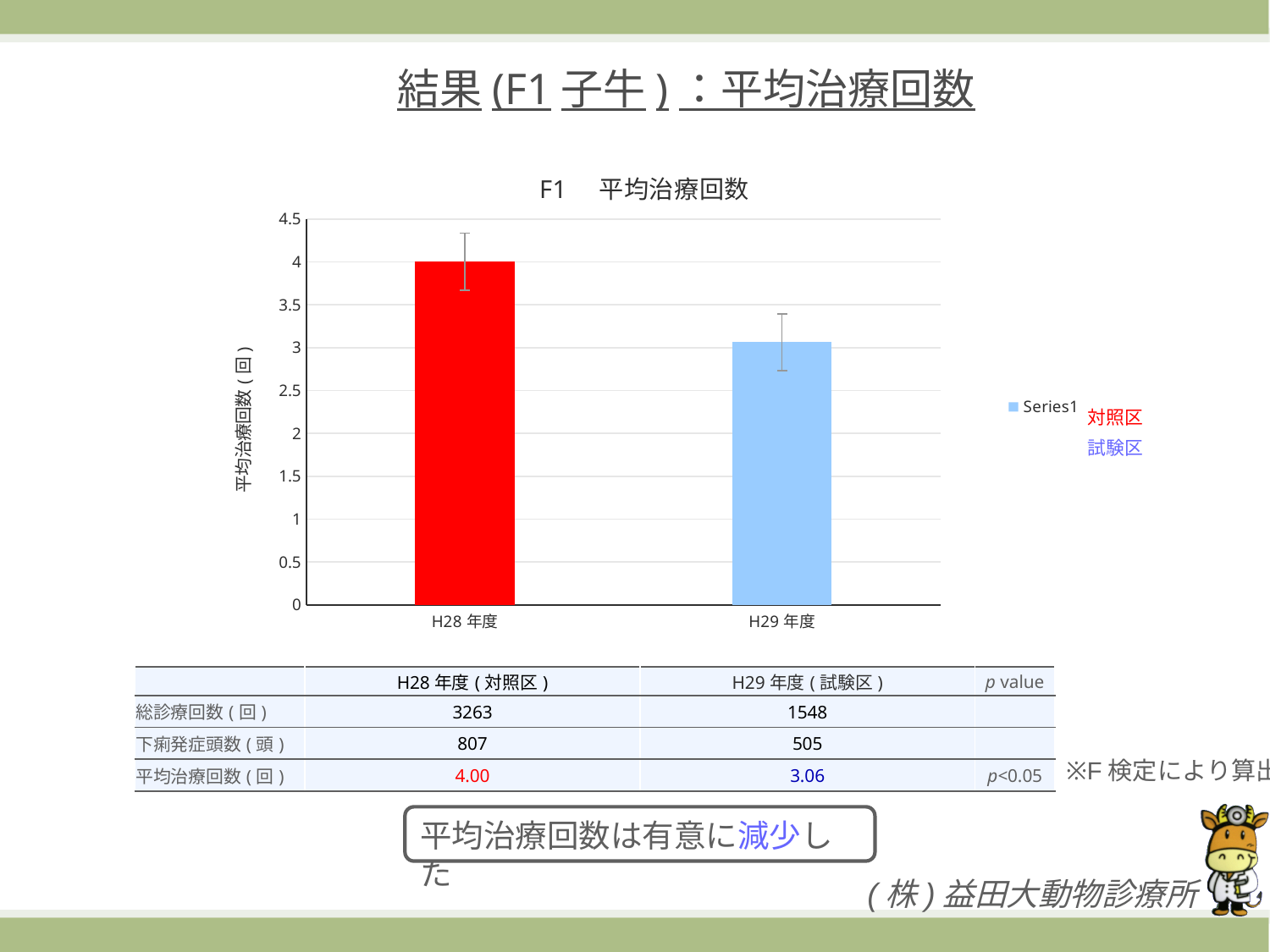
How many bars (categories) are plotted in the chart? 2 Which is larger, the value for H28年度 or the value for H29年度? H28年度 What kind of chart is shown on the slide? bar chart Which category has the lowest average number of treatments? H29年度 What is the title of the chart? F1 平均治療回数 What is the average number of treatments for H29年度? 3.06 What is the average number of treatments for H28年度? 4.00 How many series does the chart legend list? 1 Is the value for H29年度 greater or less than 3.5? less Which category has the highest average number of treatments? H28年度 What is the label of the vertical axis? 平均治療回数(回) Do the values rise or fall from H28年度 to H29年度? fall